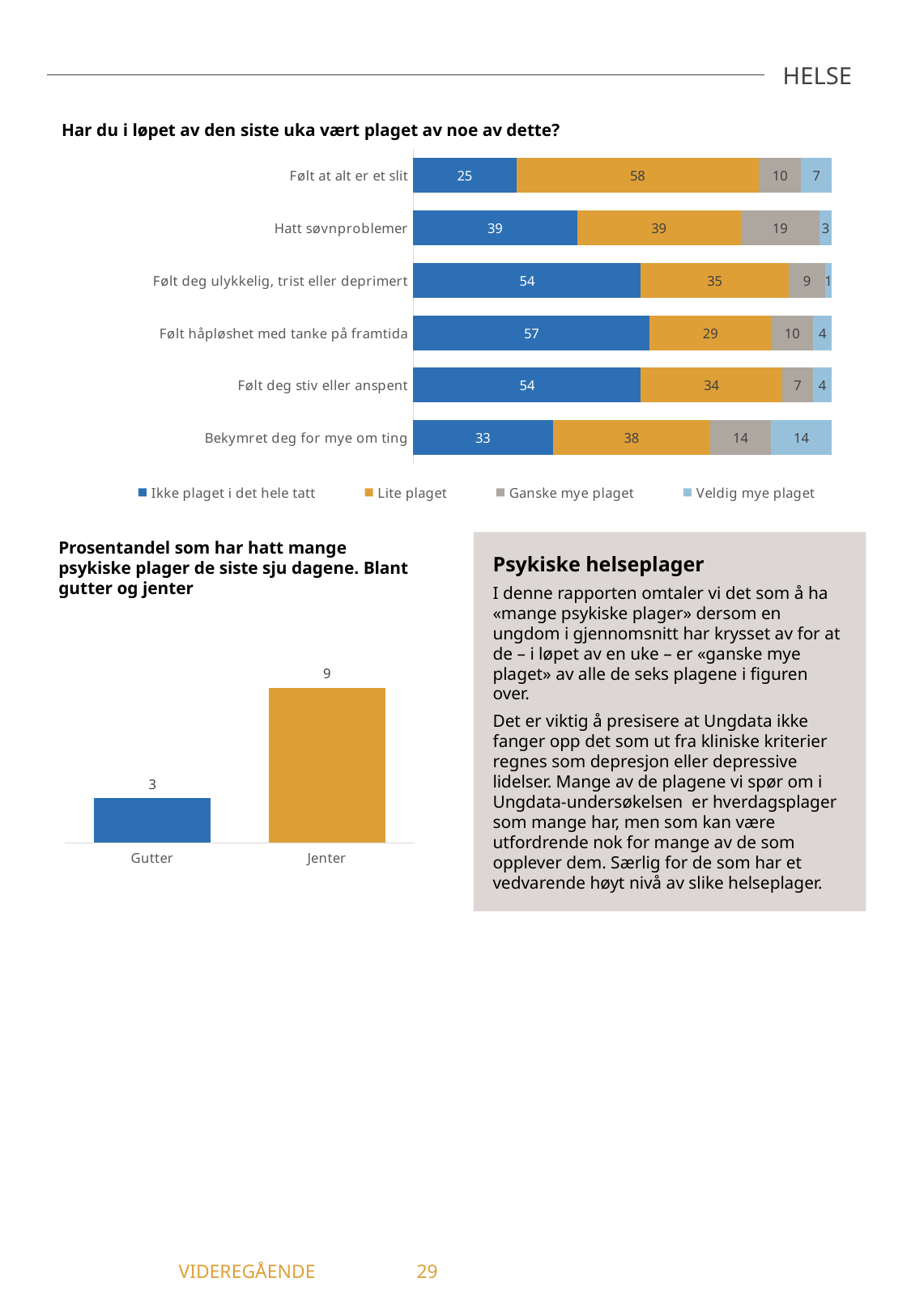
In the chart 'Har du i løpet av den siste uka vært plaget av noe av dette?', what is the value for 'Ikke plaget i det hele tatt' for 'Hatt søvnproblemer'? 39 In the chart 'Har du i løpet av den siste uka vært plaget av noe av dette?', which category has the lowest value for 'Veldig mye plaget'? Følt deg ulykkelig, trist eller deprimert In the chart 'Har du i løpet av den siste uka vært plaget av noe av dette?', what is the value for 'Veldig mye plaget' for 'Bekymret deg for mye om ting'? 14 In the chart 'Prosentandel som har hatt mange psykiske plager de siste sju dagene', what is the value for 'Jenter'? 9 In the chart 'Har du i løpet av den siste uka vært plaget av noe av dette?', what is the value for 'Lite plaget' for 'Følt at alt er et slit'? 58 In the chart 'Har du i løpet av den siste uka vært plaget av noe av dette?', which category has the highest value for 'Ikke plaget i det hele tatt'? Følt håpløshet med tanke på framtida In the chart 'Har du i løpet av den siste uka vært plaget av noe av dette?', how many series does the legend list? 4 In the chart 'Har du i løpet av den siste uka vært plaget av noe av dette?', what is the difference between the 'Ganske mye plaget' values for 'Hatt søvnproblemer' and 'Følt deg stiv eller anspent'? 12 What kind of chart is the chart 'Prosentandel som har hatt mange psykiske plager de siste sju dagene'? Bar chart In the chart 'Prosentandel som har hatt mange psykiske plager de siste sju dagene', what is the difference between 'Jenter' and 'Gutter'? 6 In the chart 'Har du i løpet av den siste uka vært plaget av noe av dette?', what is the total of the stacked bar for 'Følt håpløshet med tanke på framtida'? 100 In the chart 'Har du i løpet av den siste uka vært plaget av noe av dette?', how many categories are shown? 6